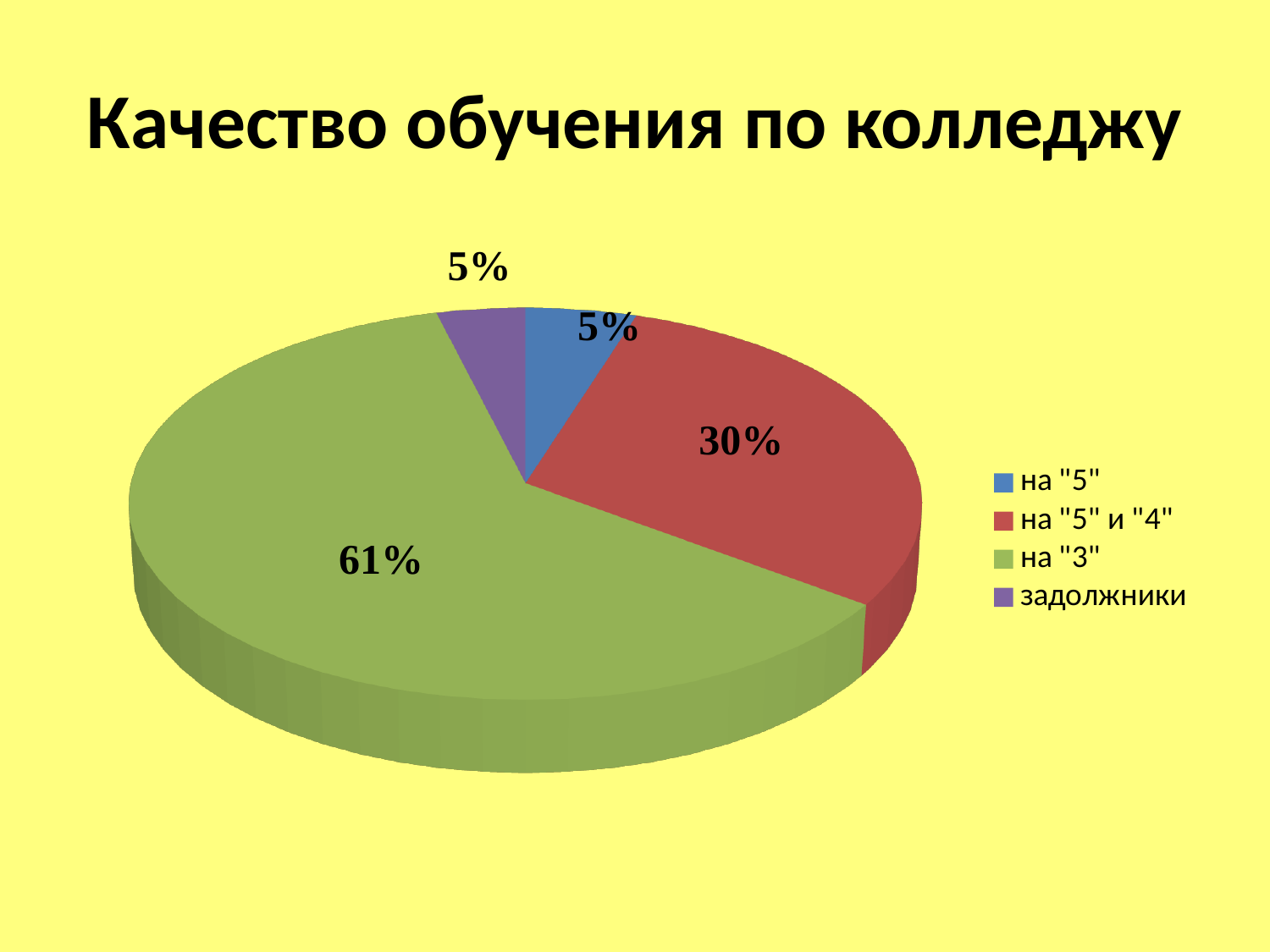
What share of the pie does the slice for на "5" и "4" represent? 30% Which category has the largest slice of the pie? на "3" What share of the pie does the slice for на "5" represent? 5% What is the title of the chart on the slide? Качество обучения по колледжу What is the difference between the shares for на "3" and на "5" и "4"? 31% How many categories does the pie chart show? 4 What is the difference between the shares for на "5" и "4" and задолжники? 25% Which colour represents задолжники in the legend? purple Which is larger, the slice for на "5" и "4" or the slice for на "5"? на "5" и "4" What share of the pie does the slice for задолжники represent? 5% What kind of chart is shown on the slide? pie chart